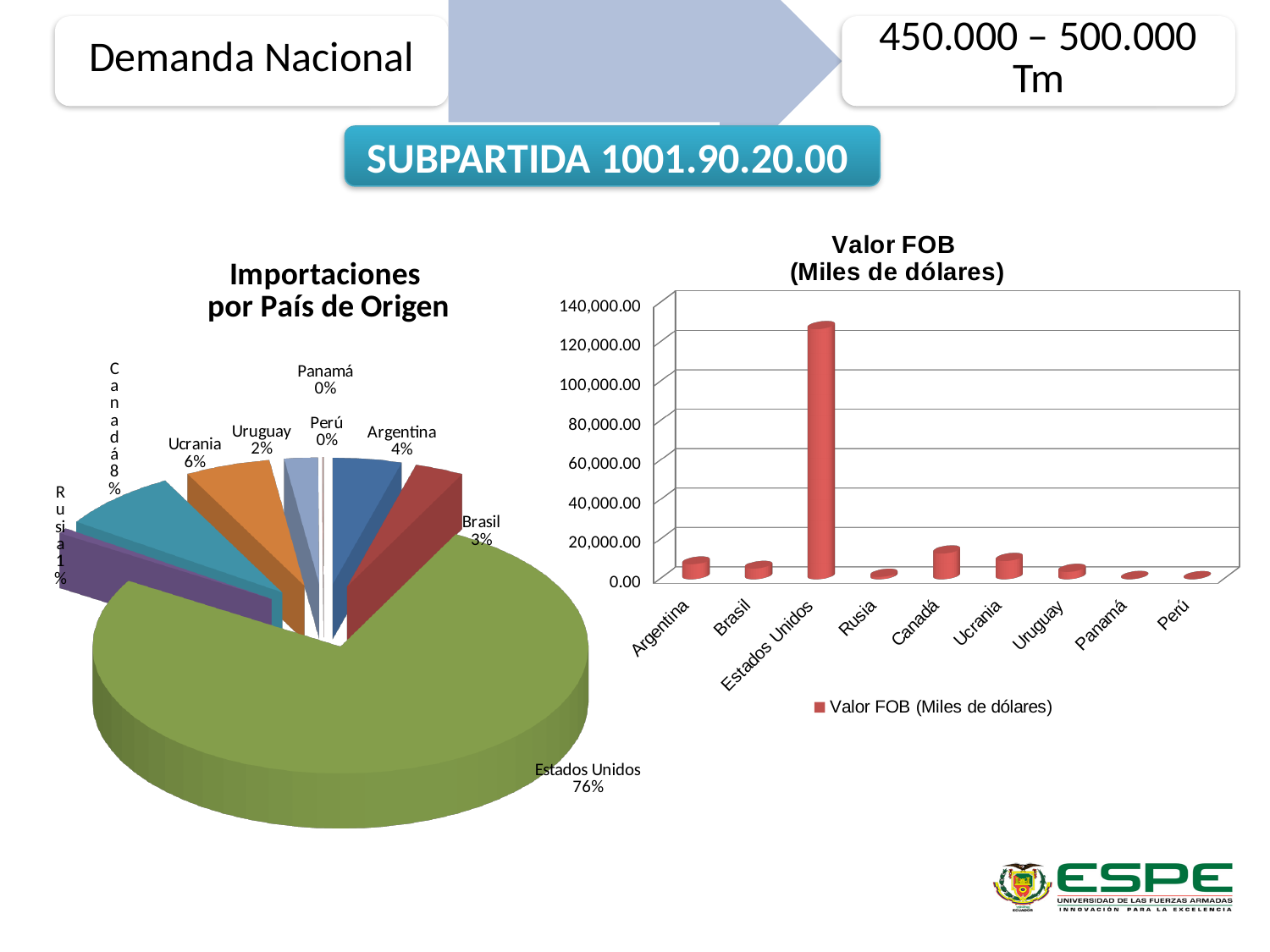
In the bar chart 'Valor FOB (Miles de dólares)', which country has the highest value? Estados Unidos In the pie chart 'Importaciones por País de Origen', which has a larger share, Ucrania or Uruguay? Ucrania In the pie chart 'Importaciones por País de Origen', which country has the largest share? Estados Unidos In the pie chart 'Importaciones por País de Origen', what share of imports comes from Canadá? 8% In the bar chart 'Valor FOB (Miles de dólares)', is the value for Estados Unidos greater or less than 120,000.00? greater In the pie chart 'Importaciones por País de Origen', what is the difference in percentage points between the shares of Argentina and Brasil? 1 In the bar chart 'Valor FOB (Miles de dólares)', is the value for Canadá greater or less than 20,000.00? less How many countries are shown in the pie chart 'Importaciones por País de Origen'? 9 In the pie chart 'Importaciones por País de Origen', what share of imports comes from Ucrania? 6% What kind of chart is 'Valor FOB (Miles de dólares)'? bar chart How many series does the legend of the bar chart 'Valor FOB (Miles de dólares)' list? 1 In the pie chart 'Importaciones por País de Origen', what share of imports comes from Estados Unidos? 76%